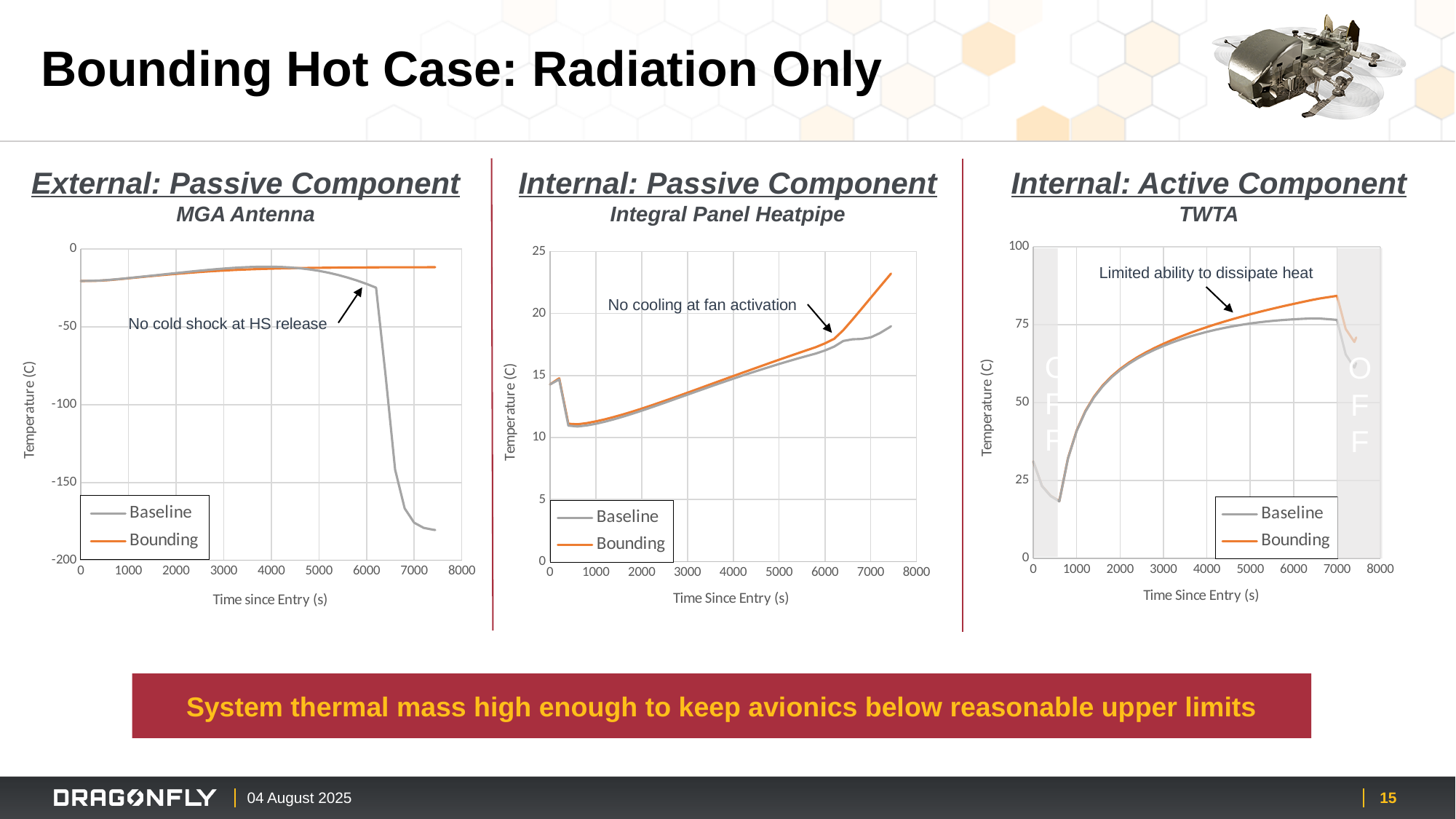
In the MGA Antenna chart, is the Baseline value at 7000 s greater or less than -150? less What are the two series named in the legend of the Integral Panel Heatpipe chart? Baseline and Bounding In the TWTA chart, which series is higher at 7000 s, Baseline or Bounding? Bounding In the TWTA chart, is the Bounding value at 7000 s greater or less than 75? greater In the Integral Panel Heatpipe chart, do the temperatures rise or fall between 1000 s and 6000 s? rise In the MGA Antenna chart, is the Bounding value at 7000 s greater or less than -50? greater What is the x-axis label of the TWTA chart? Time Since Entry (s) What kind of chart is the MGA Antenna chart on the left? line chart In the MGA Antenna chart, which series is higher at 7000 s, Baseline or Bounding? Bounding How many series does the legend of the TWTA chart list? 2